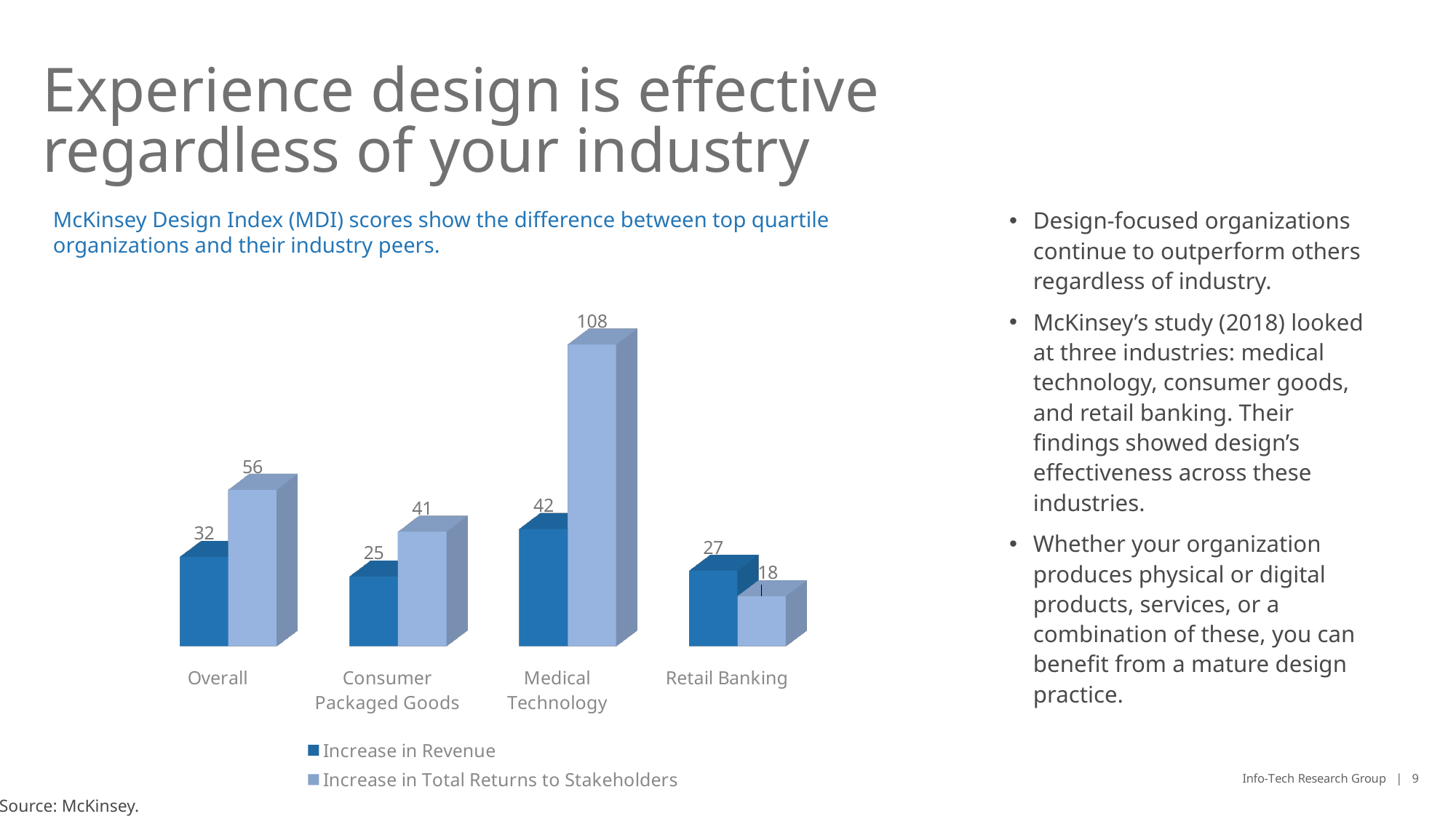
What is the difference between the Increase in Total Returns to Stakeholders for Overall and for Consumer Packaged Goods? 15 What is the Increase in Revenue value for Retail Banking? 27 How many categories are shown on the x axis? 4 How many series does the legend list? 2 What is the Increase in Total Returns to Stakeholders value for Overall? 56 Which category has the lowest Increase in Revenue? Consumer Packaged Goods Which category has the highest Increase in Total Returns to Stakeholders? Medical Technology What is the Increase in Revenue value for Medical Technology? 42 What is the difference between Increase in Total Returns to Stakeholders and Increase in Revenue for Medical Technology? 66 Which series is shown in the darker blue colour? Increase in Revenue What kind of chart is shown on the slide? Bar chart For Retail Banking, which is larger: Increase in Revenue or Increase in Total Returns to Stakeholders? Increase in Revenue